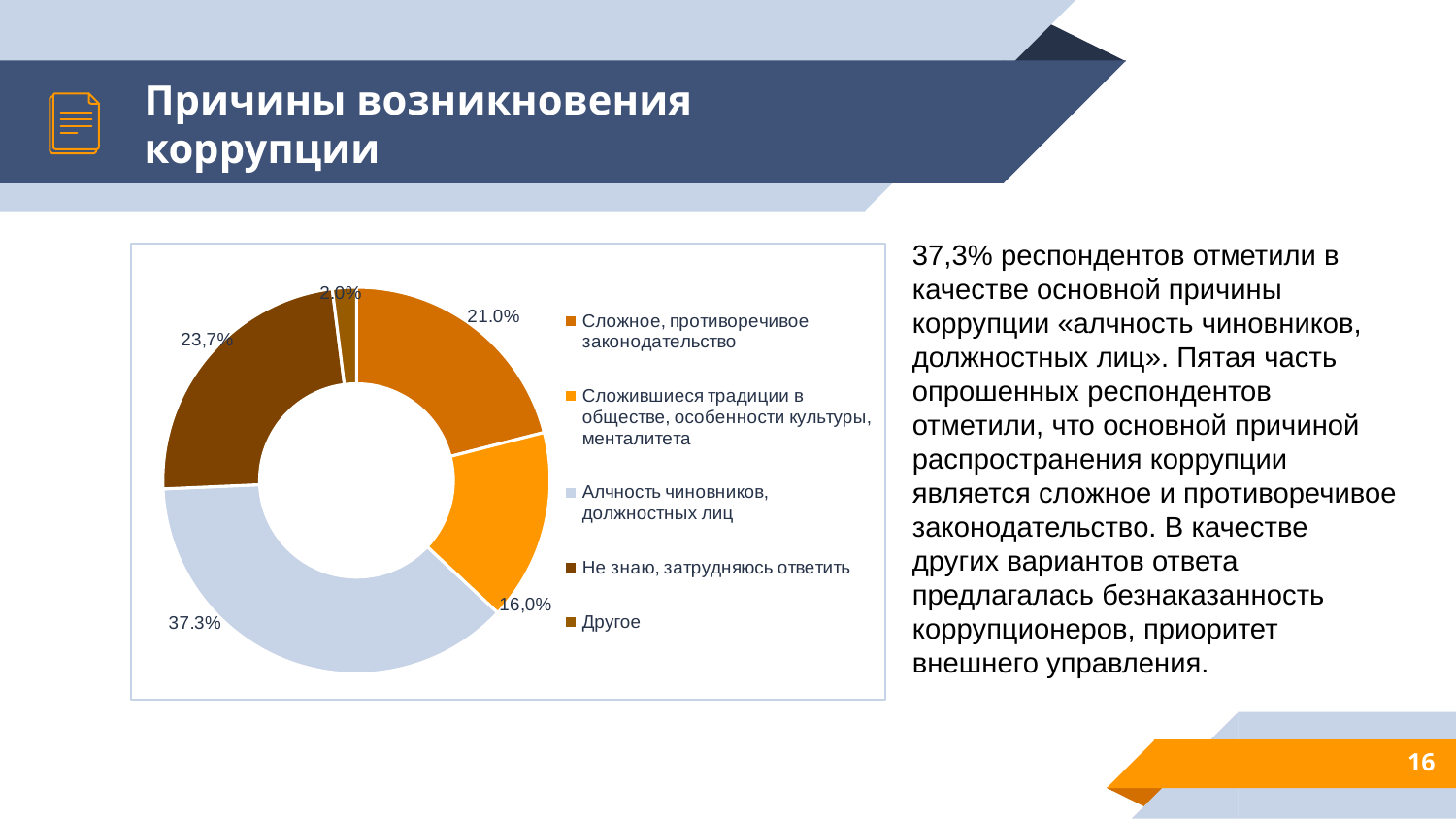
What colour is the slice for «Алчность чиновников, должностных лиц»? light blue-grey Which is larger: the share for «Сложное, противоречивое законодательство» or for «Сложившиеся традиции в обществе, особенности культуры, менталитета»? Сложное, противоречивое законодательство What kind of chart is shown on the slide? doughnut (pie) chart Which category has the largest share in the chart? Алчность чиновников, должностных лиц Which category has the smallest share in the chart? Другое What share of respondents chose «Сложившиеся традиции в обществе, особенности культуры, менталитета»? 16,0% What share of respondents chose «Сложное, противоречивое законодательство»? 21.0% What share of respondents chose «Алчность чиновников, должностных лиц»? 37.3% By how many percentage points does «Алчность чиновников, должностных лиц» exceed «Не знаю, затрудняюсь ответить»? 13.6 percentage points What share of respondents answered «Не знаю, затрудняюсь ответить»? 23,7% What share of respondents chose «Другое»? 2,0% How many categories does the chart show? 5